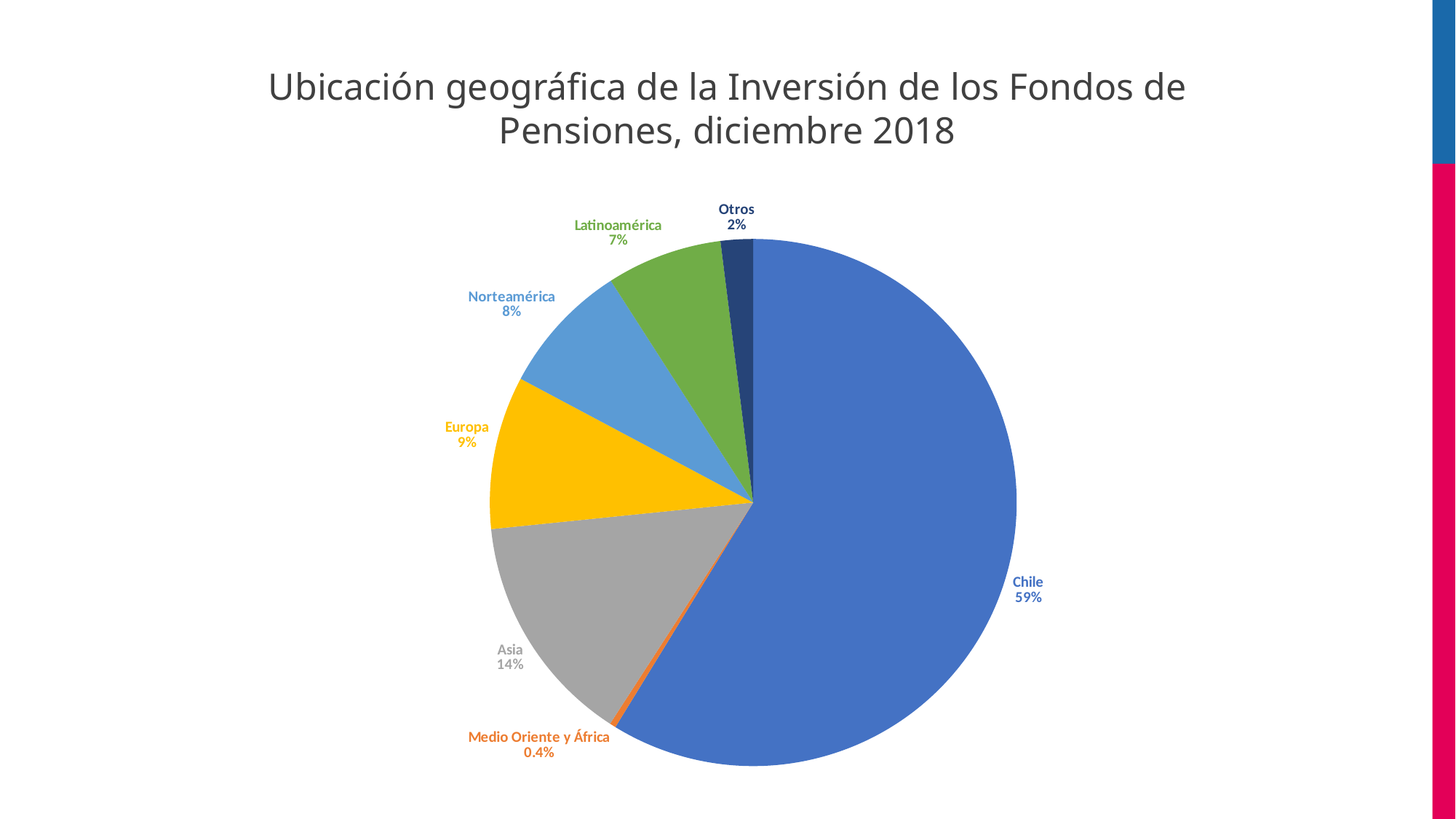
Which category has the smallest slice of the pie? Medio Oriente y África What is the value shown for Europa? 9% What is the difference between the values for Asia and Europa? 5% What is the value shown for Asia? 14% What is the difference between the values for Chile and Asia? 45% Which is larger, Norteamérica or Latinoamérica? Norteamérica What is the title of the chart? Ubicación geográfica de la Inversión de los Fondos de Pensiones, diciembre 2018 What share of the pie does Chile represent? 59% What kind of chart is shown on the slide? Pie chart Which category has the largest slice of the pie? Chile What is the value shown for Medio Oriente y África? 0.4% How many slices does the pie chart have? 7